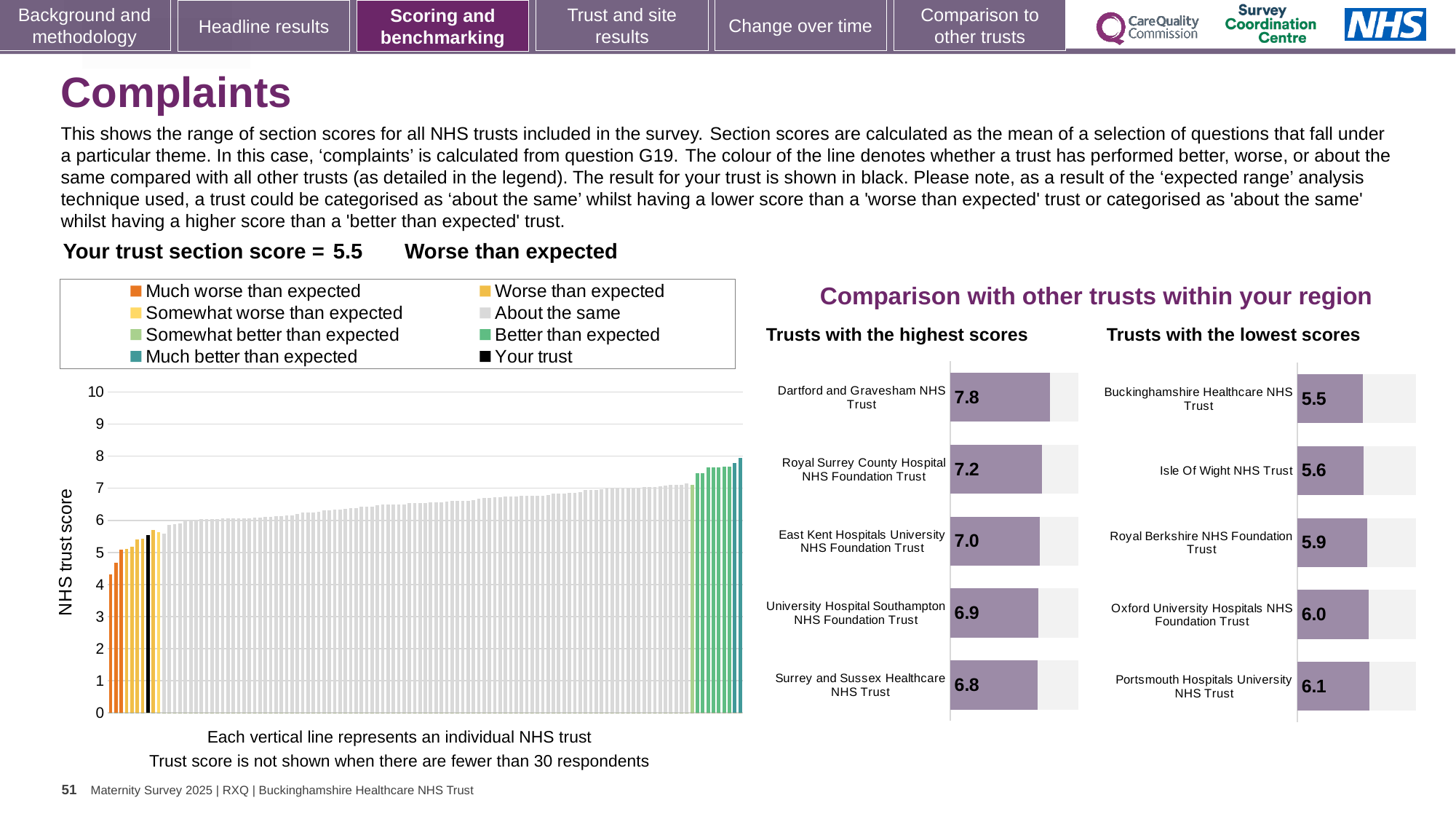
In the 'Trusts with the lowest scores' chart, which trust has the highest score shown? Portsmouth Hospitals University NHS Trust In the 'Trusts with the highest scores' chart, what is the score for Dartford and Gravesham NHS Trust? 7.8 In the 'Trusts with the lowest scores' chart, which has the larger score: Royal Berkshire NHS Foundation Trust or Oxford University Hospitals NHS Foundation Trust? Oxford University Hospitals NHS Foundation Trust What kind of chart is the main NHS trust score chart? bar chart In the 'Trusts with the highest scores' chart, what is the difference between the scores of Dartford and Gravesham NHS Trust and Royal Surrey County Hospital NHS Foundation Trust? 0.6 In the 'Trusts with the highest scores' chart, which trust has the lowest score shown? Surrey and Sussex Healthcare NHS Trust How many entries does the legend above the main NHS trust score chart list? 8 In the main NHS trust score chart, what is the section score for your trust (the black bar)? 5.5 How many trusts are listed in the 'Trusts with the lowest scores' chart? 5 In the main NHS trust score chart, is the value for your trust (the black bar) greater or less than 6? less In the main NHS trust score chart, do the bar values rise or fall from left to right? rise In the 'Trusts with the lowest scores' chart, what is the score for Isle Of Wight NHS Trust? 5.6